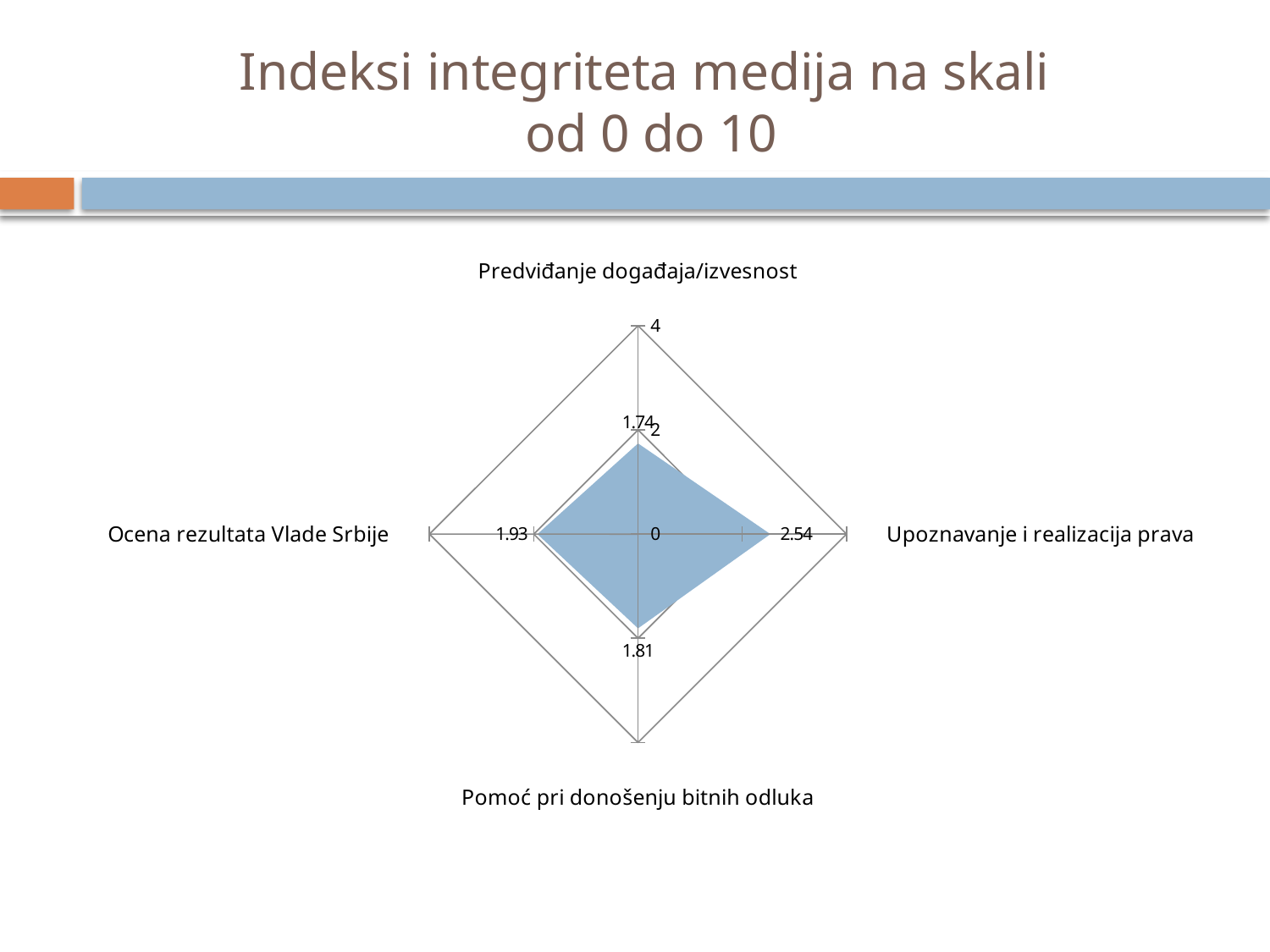
What is the value for Upoznavanje i realizacija prava? 2.54 What is the value for Ocena rezultata Vlade Srbije? 1.93 What is the difference between the values for Upoznavanje i realizacija prava and Predviđanje događaja/izvesnost? 0.80 What is the value for Pomoć pri donošenju bitnih odluka? 1.81 What is the title of the slide? Indeksi integriteta medija na skali od 0 do 10 How many categories does the chart have? 4 Is the value for Upoznavanje i realizacija prava greater or less than 2? greater What is the value for Predviđanje događaja/izvesnost? 1.74 Which category has the lowest value? Predviđanje događaja/izvesnost Which category has the highest value? Upoznavanje i realizacija prava What kind of chart is shown on the slide? radar chart Which is larger, the value for Ocena rezultata Vlade Srbije or the value for Pomoć pri donošenju bitnih odluka? Ocena rezultata Vlade Srbije